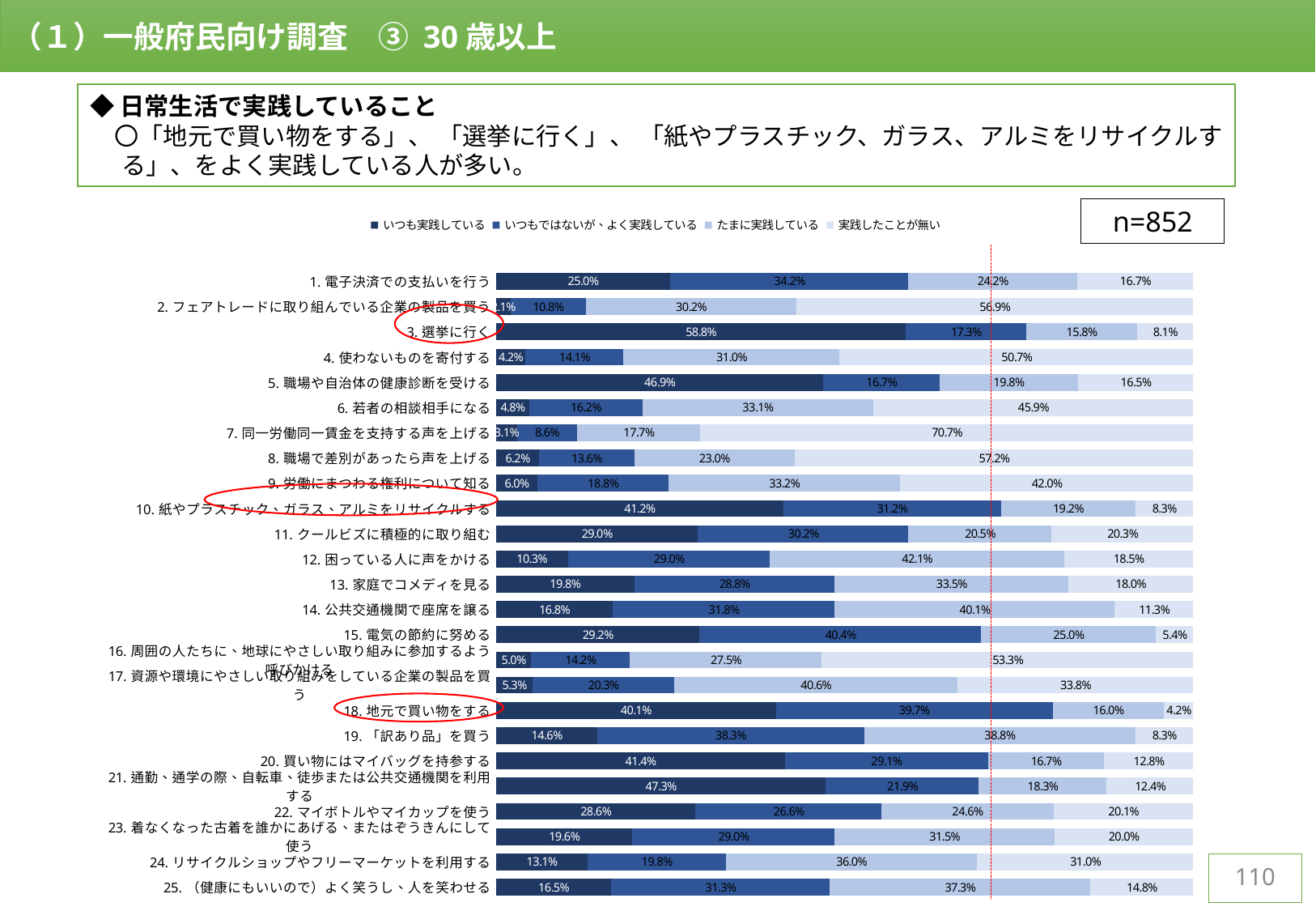
How many categories (items) are plotted in the chart? 25 What is the value of いつも実践している for 3. 選挙に行く? 58.8% Which item has the highest value for 実践したことが無い? 7. 同一労働同一賃金を支持する声を上げる What sample size (n) is shown on the slide for this chart? n=852 What is the value of たまに実践している for 1. 電子決済での支払いを行う? 24.2% What is the value of 実践したことが無い for 7. 同一労働同一賃金を支持する声を上げる? 70.7% Which has a larger いつも実践している value: 1. 電子決済での支払いを行う or 15. 電気の節約に努める? 15. 電気の節約に努める What kind of chart is shown on the slide? Stacked bar chart What is the value of いつもではないが、よく実践している for 18. 地元で買い物をする? 39.7% How many series does the legend list? 4 Which item has the highest value for いつも実践している? 3. 選挙に行く What is the difference between the いつも実践している values for 3. 選挙に行く and 10. 紙やプラスチック、ガラス、アルミをリサイクルする? 17.6 percentage points